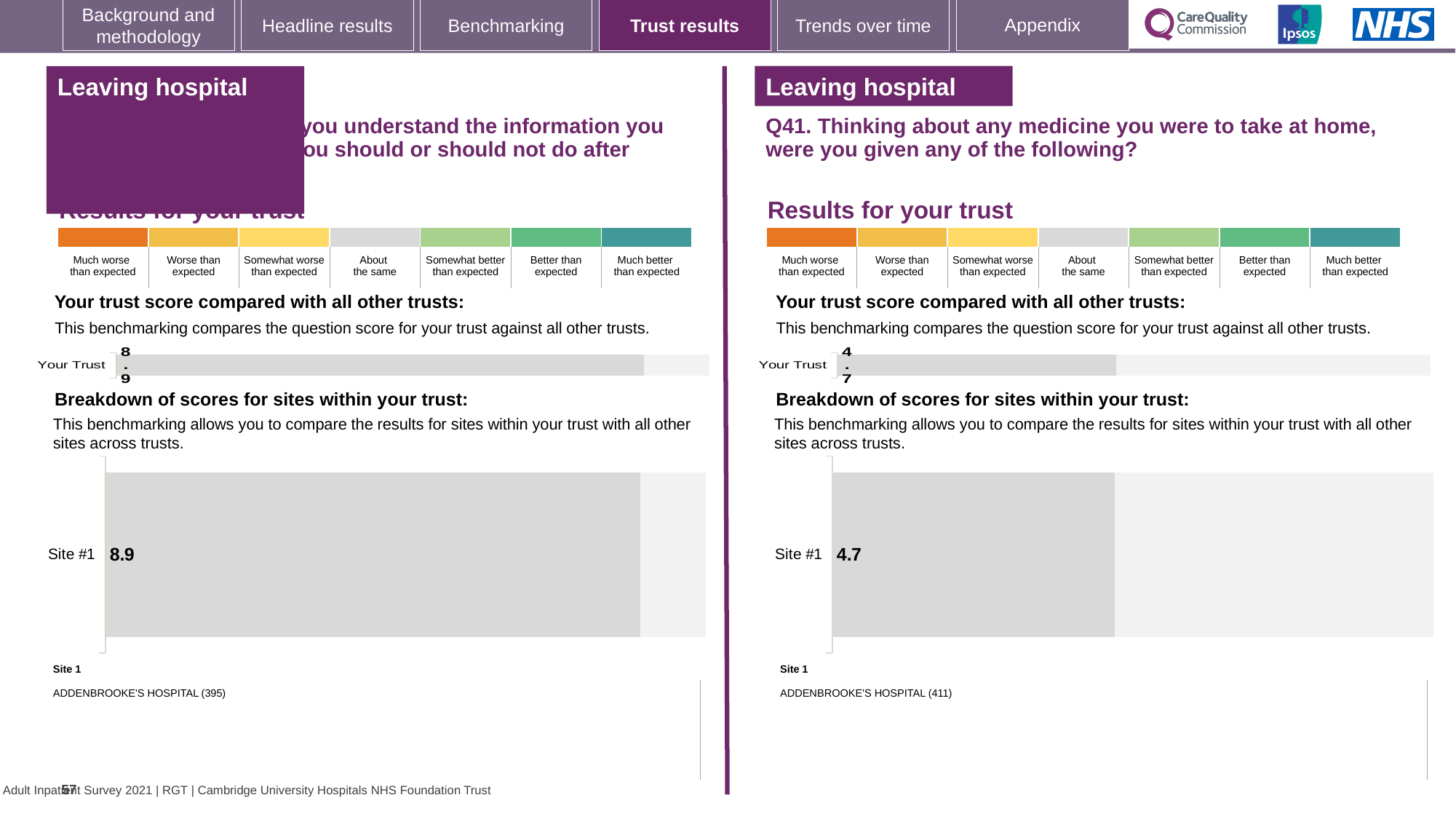
How many sites are shown in the left-hand site breakdown chart? 1 What type of chart is used to show the Site #1 score on the right half of the slide? Bar chart Which hospital is listed as Site 1 below the right-hand chart (Q41)? ADDENBROOKE'S HOSPITAL (411) What is the difference between the Site #1 score in the left-hand chart and the Site #1 score in the right-hand chart (Q41)? 4.2 Which hospital is listed as Site 1 below the left-hand chart? ADDENBROOKE'S HOSPITAL (395) In the left-hand site breakdown chart, what is the score for Site #1? 8.9 Which is larger: the Your Trust score on the left half of the slide or the Your Trust score on the right half (Q41)? Left half (8.9) In the right-hand site breakdown chart (Q41), what is the score for Site #1? 4.7 How many sites are shown in the right-hand site breakdown chart (Q41)? 1 On the right half of the slide (Q41), what is the score shown for Your Trust? 4.7 On the left half of the slide, what is the score shown for Your Trust? 8.9